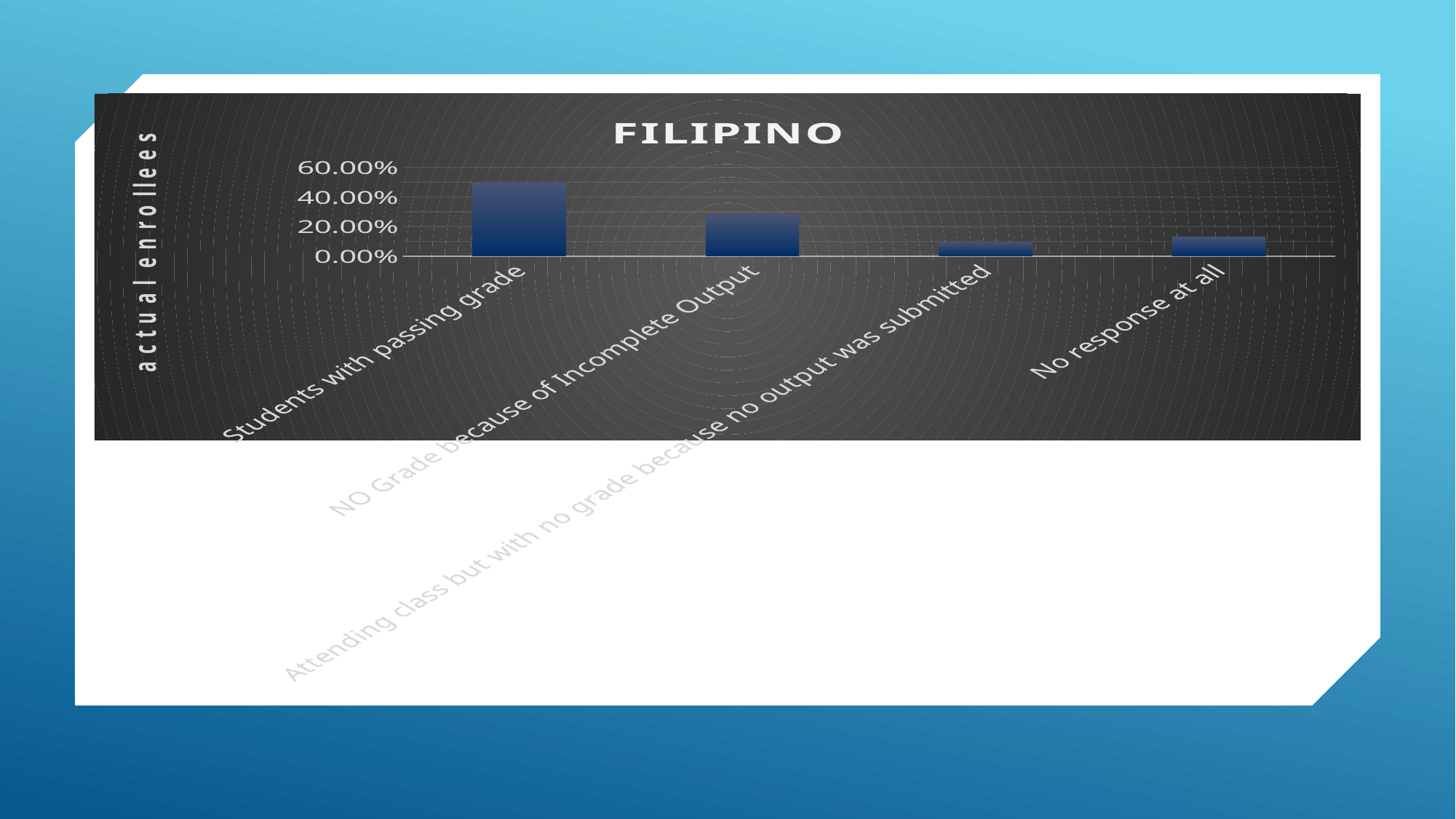
Which is larger: the value for No response at all or the value for Attending class but with no grade because no output was submitted? No response at all What kind of chart is shown on the slide? bar chart What is the title of the chart? FILIPINO Which category has the highest value? Students with passing grade Is the value for NO Grade because of Incomplete Output greater or less than 40.00%? less Is the value for No response at all greater or less than 20.00%? less Which is larger: the value for Students with passing grade or the value for NO Grade because of Incomplete Output? Students with passing grade What is the label on the vertical axis of the chart? actual enrollees How many categories are plotted in the chart? 4 Is the value for Students with passing grade greater or less than 40.00%? greater Which category has the lowest value? Attending class but with no grade because no output was submitted